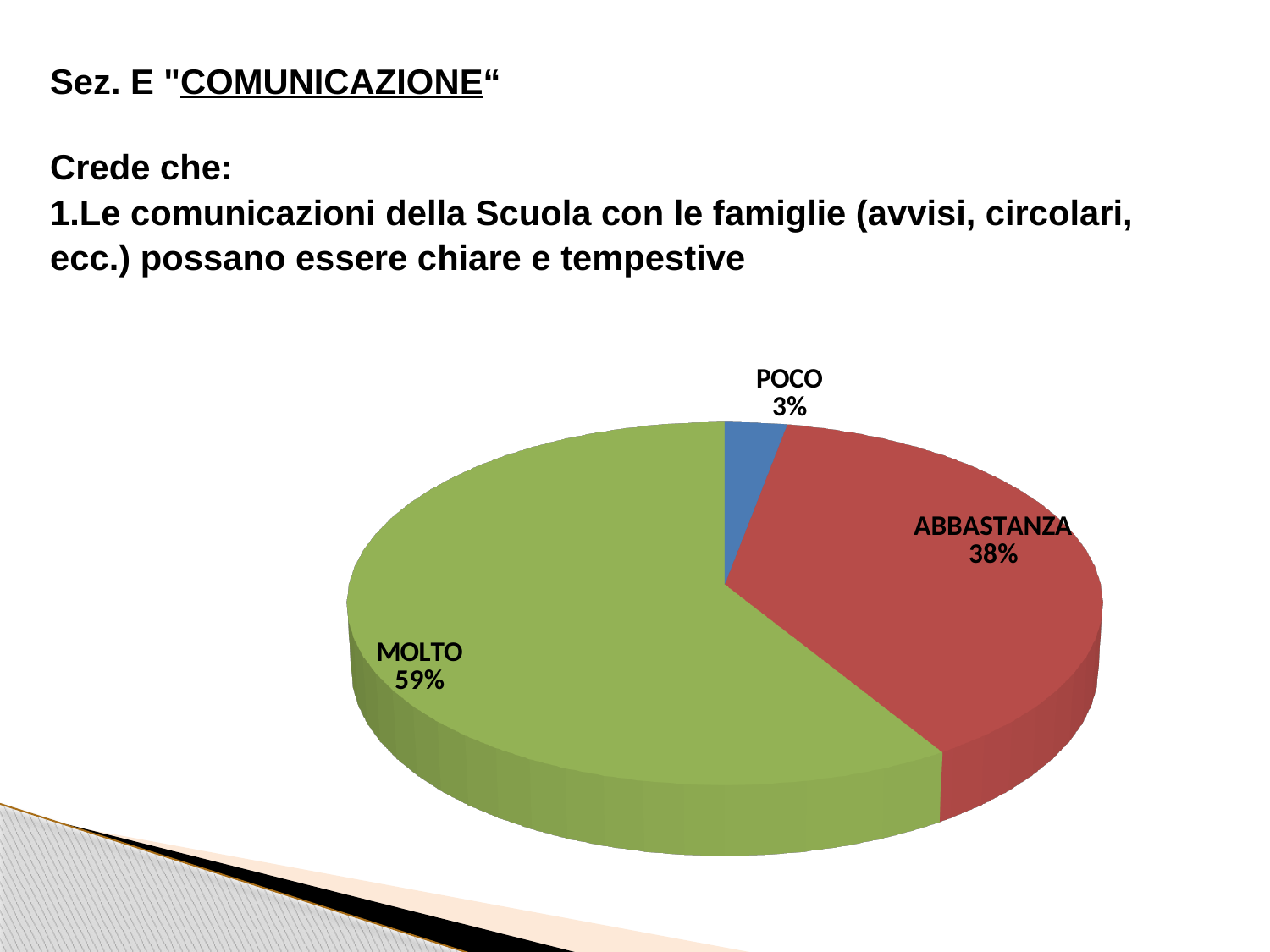
Which is larger, the share for ABBASTANZA or the share for POCO? ABBASTANZA Which category has the smallest slice of the pie? POCO What colour is the POCO slice of the pie? blue How many slices does the pie chart have? 3 What share of the pie does ABBASTANZA represent? 38% What is the difference in percentage points between MOLTO and ABBASTANZA? 21 What kind of chart is shown on the slide? pie chart What share of the pie does POCO represent? 3% What share of the pie does MOLTO represent? 59% Which category has the largest slice of the pie? MOLTO What is the difference in percentage points between ABBASTANZA and POCO? 35 What colour is the MOLTO slice of the pie? green